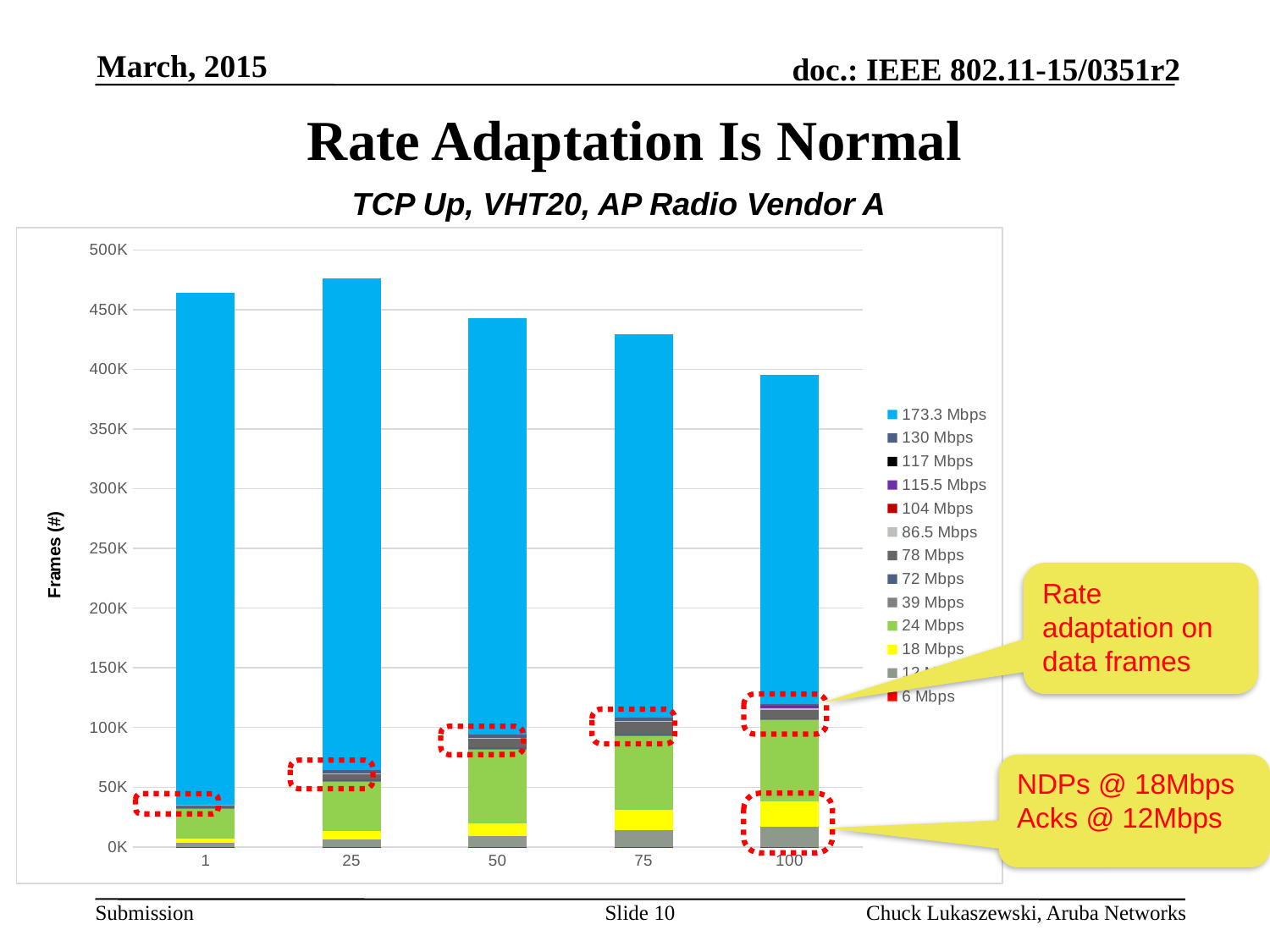
Is the total for category 1 greater or less than 450K? greater What kind of chart is shown on the slide? Stacked bar chart Which series is listed first in the legend? 173.3 Mbps What is the label on the y axis? Frames (#) How many series does the legend list? 13 Is the total for category 75 greater or less than 450K? less From category 25 to category 100, do the bar totals rise or fall? fall Which category has the tallest stacked bar? 25 Which category has the shortest stacked bar? 100 Is the total for category 100 greater or less than 350K? greater Which has the larger total, category 1 or category 100? 1 How many categories are shown along the x axis? 5